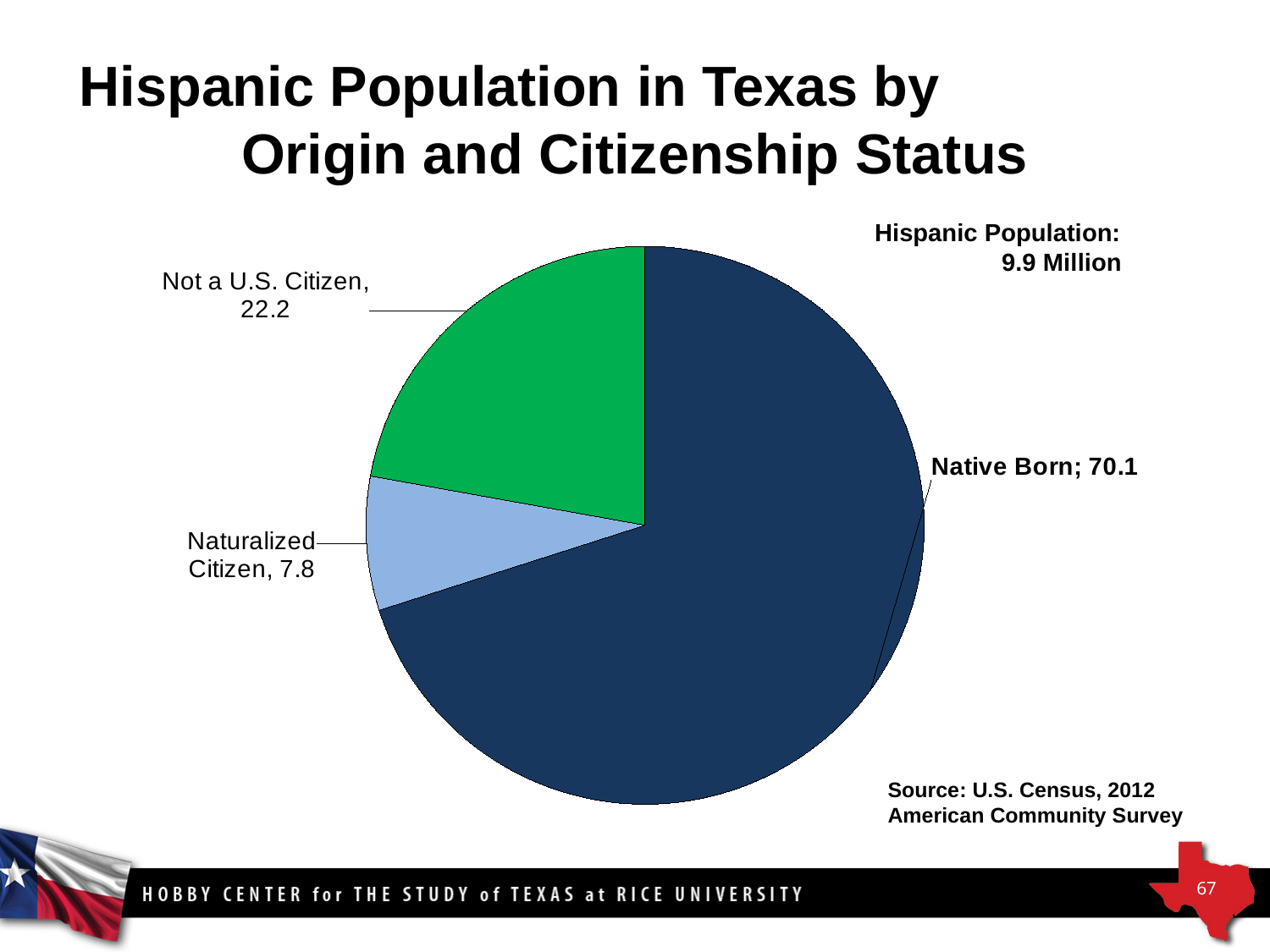
What is the value for Native Born? 70.1 Which category has the largest slice of the pie? Native Born What is the value for Naturalized Citizen? 7.8 Which category has the smallest slice of the pie? Naturalized Citizen What kind of chart is shown on the slide? pie chart Which is larger, the value for Not a U.S. Citizen or the value for Naturalized Citizen? Not a U.S. Citizen What is the difference between the values for Native Born and Not a U.S. Citizen? 47.9 What colour is the Not a U.S. Citizen slice? green How many slices does the pie chart have? 3 What is the value for Not a U.S. Citizen? 22.2 What is the difference between the values for Not a U.S. Citizen and Naturalized Citizen? 14.4 What total Hispanic population is stated on the slide? 9.9 Million